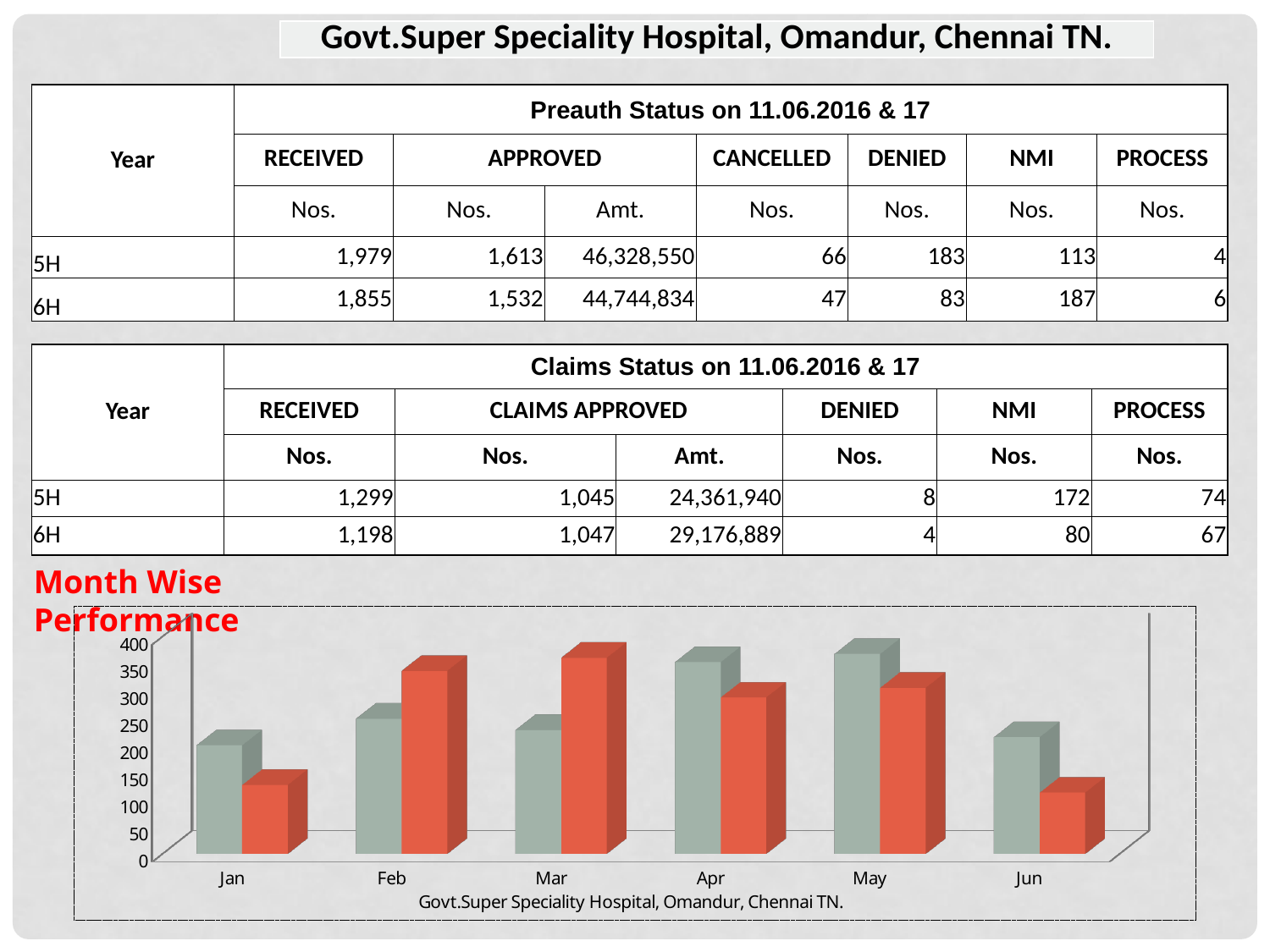
In the bar chart, is the value of the red bar for Jun greater or less than 150? less In the bar chart, is the value of the grey bar for Jan greater or less than 150? greater In the bar chart, is the value of the red bar for Feb greater or less than 300? greater In the bar chart, which bar is taller for Jun, the grey bar or the red bar? the grey bar Which month is the first category on the x axis of the bar chart? Jan What text appears as the title beneath the bar chart? Govt.Super Speciality Hospital, Omandur, Chennai TN. What kind of chart is shown under the heading "Month Wise Performance"? bar chart How many months are shown on the x axis of the bar chart? 6 In the bar chart, which bar is taller for Feb, the grey bar or the red bar? the red bar In the bar chart, which bar is taller for Apr, the grey bar or the red bar? the grey bar